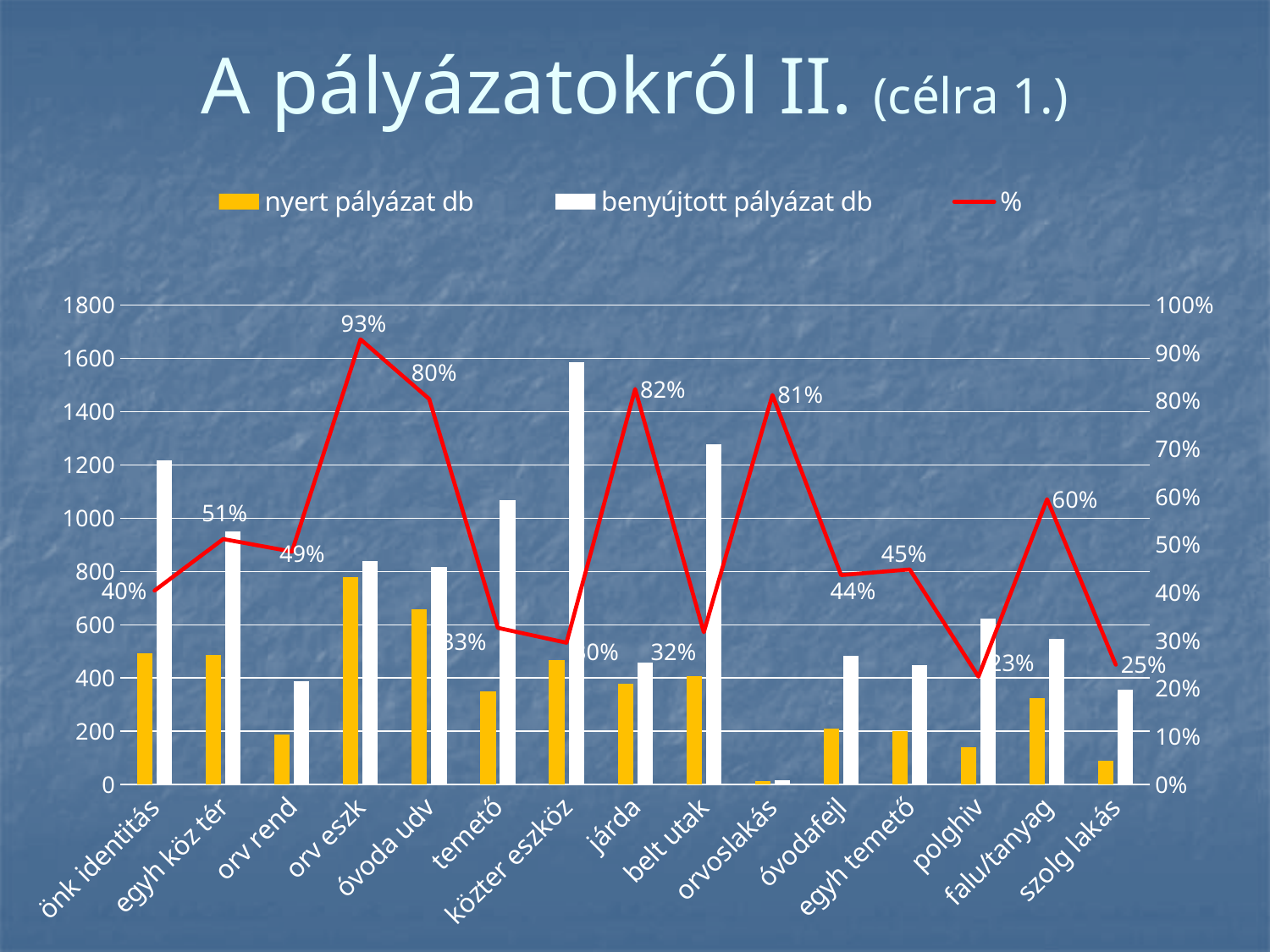
How many series does the legend list? 3 What is the % value for falu/tanyag? 60% Is the benyújtott pályázat db value for önk identitás greater or less than 1000? greater Which category has the highest % value? orv eszk What type of chart is shown on the slide? Combined bar and line chart Which has a higher % value, orv eszk or óvoda udv? orv eszk Which category has the lowest % value? polghiv Which category has the tallest benyújtott pályázat db bar? közter eszköz What is the % value for orv eszk? 93% What is the % value for járda? 82% What is the difference between the % value for orv eszk and the % value for polghiv? 70 percentage points How many categories are shown on the x axis? 15